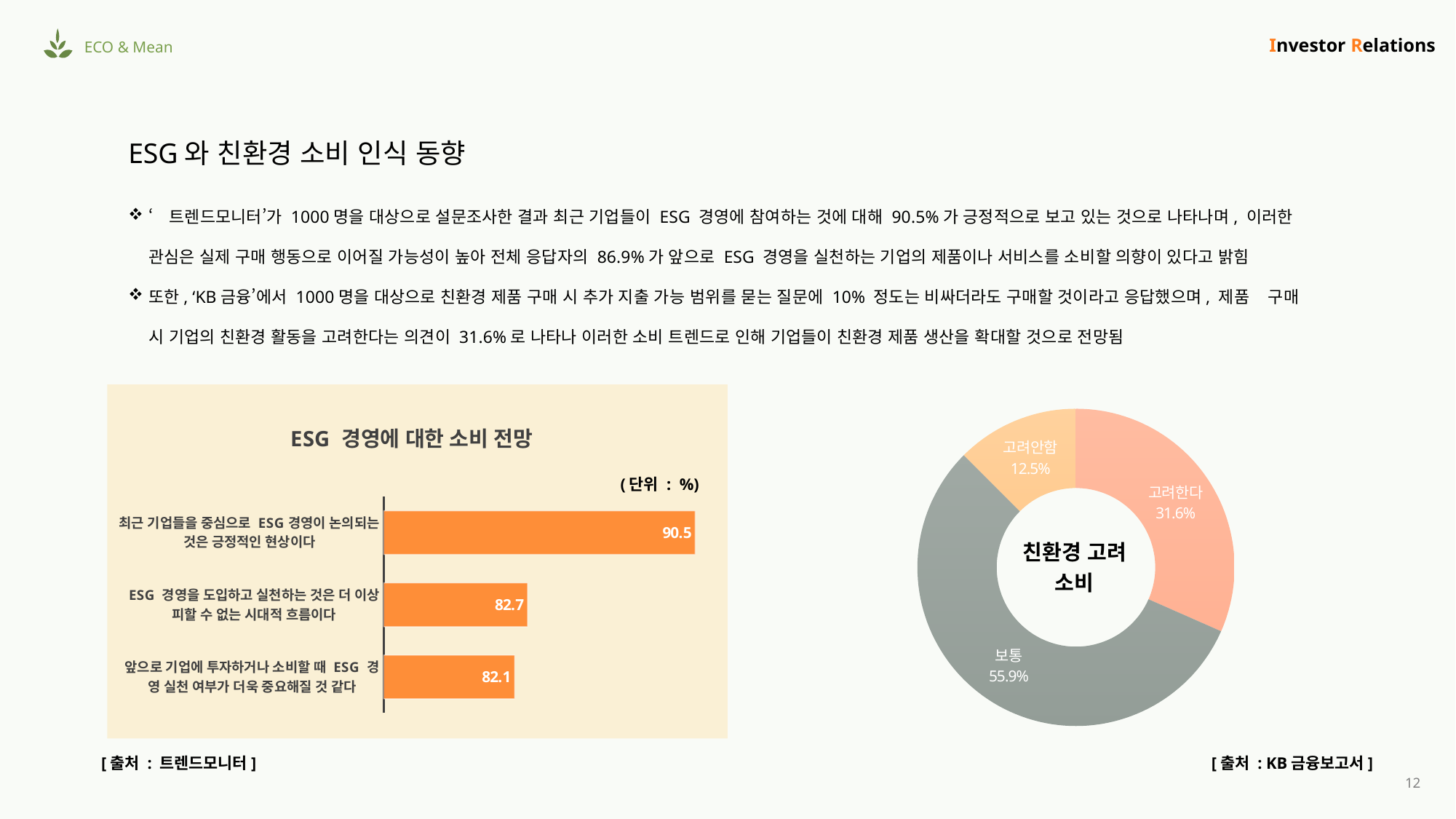
In the 'ESG 경영에 대한 소비 전망' chart on the left, what is the value for '앞으로 기업에 투자하거나 소비할 때 ESG 경영 실천 여부가 더욱 중요해질 것 같다'? 82.1 In the '친환경 고려 소비' donut chart on the right, which is larger: '고려한다' or '고려안함'? 고려한다 In the 'ESG 경영에 대한 소비 전망' chart on the left, which category has the highest value? 최근 기업들을 중심으로 ESG 경영이 논의되는 것은 긍정적인 현상이다 What kind of chart is the 'ESG 경영에 대한 소비 전망' chart on the left? Bar chart In the 'ESG 경영에 대한 소비 전망' chart on the left, how many bars are shown? 3 In the '친환경 고려 소비' donut chart on the right, what share is labelled '보통'? 55.9% In the 'ESG 경영에 대한 소비 전망' chart on the left, what is the difference between the highest value (90.5) and the lowest value (82.1)? 8.4 In the '친환경 고려 소비' donut chart on the right, which slice is the smallest? 고려안함 In the 'ESG 경영에 대한 소비 전망' chart on the left, what is the value for '최근 기업들을 중심으로 ESG 경영이 논의되는 것은 긍정적인 현상이다'? 90.5 What is the unit shown on the 'ESG 경영에 대한 소비 전망' chart on the left? % In the '친환경 고려 소비' donut chart on the right, what share is labelled '고려한다'? 31.6% In the 'ESG 경영에 대한 소비 전망' chart on the left, what is the value for 'ESG 경영을 도입하고 실천하는 것은 더 이상 피할 수 없는 시대적 흐름이다'? 82.7